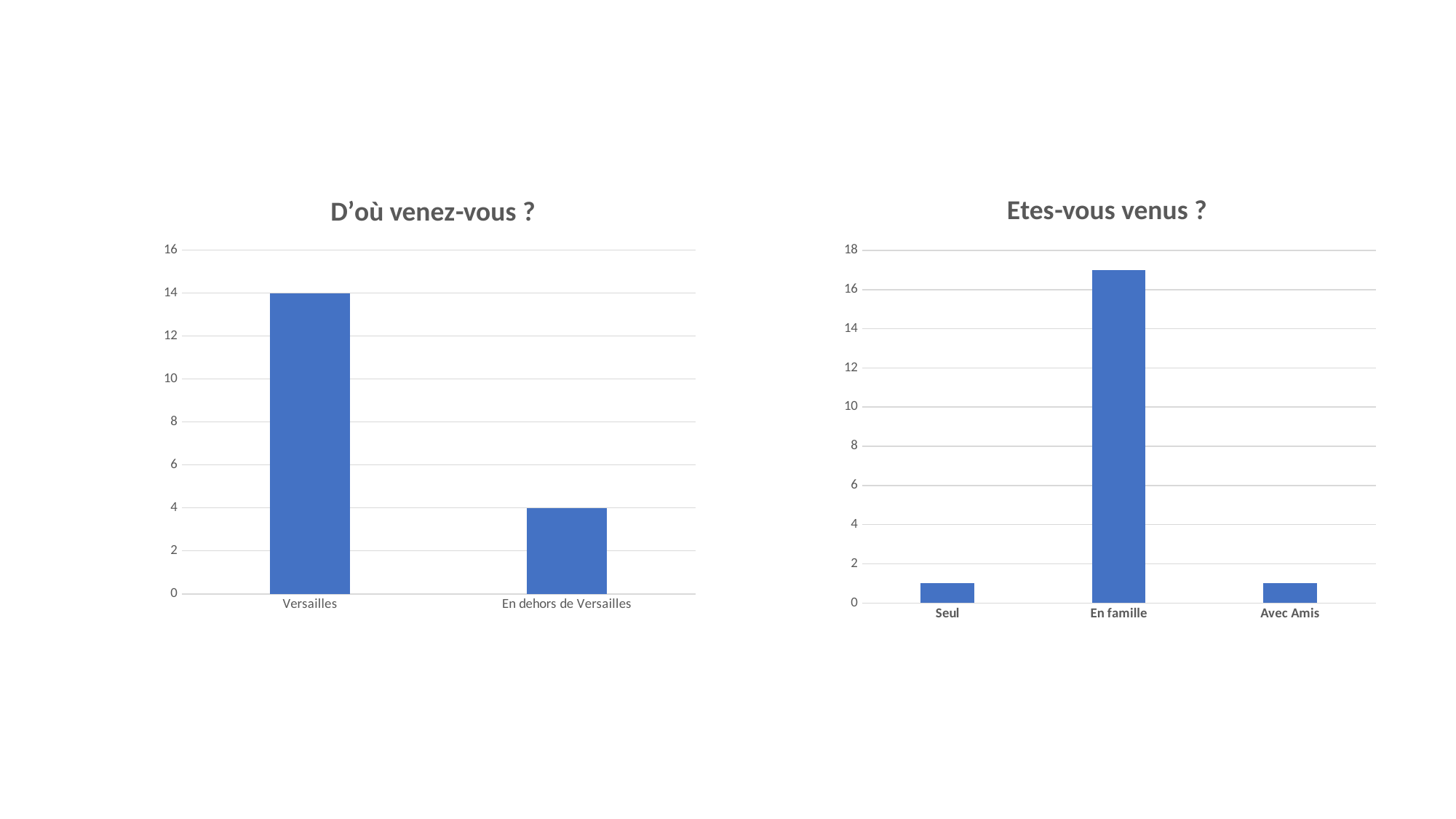
In the chart titled "D'où venez-vous ?", what is the value for Versailles? 14 In the chart titled "Etes-vous venus ?", is the value for Seul greater or less than 2? less In the chart titled "Etes-vous venus ?", is the value for En famille greater or less than 16? greater What kind of chart is the chart on the right of the slide? Bar chart In the chart titled "Etes-vous venus ?", how many categories are shown? 3 In the chart titled "D'où venez-vous ?", how many categories are shown? 2 What is the title of the chart on the left of the slide? D'où venez-vous ? In the chart titled "D'où venez-vous ?", what is the value for En dehors de Versailles? 4 In the chart titled "D'où venez-vous ?", which category has the highest value? Versailles In the chart titled "Etes-vous venus ?", which category has the highest value? En famille In the chart titled "Etes-vous venus ?", is the value for Avec Amis greater or less than 4? less In the chart titled "D'où venez-vous ?", what is the difference between the values for Versailles and En dehors de Versailles? 10